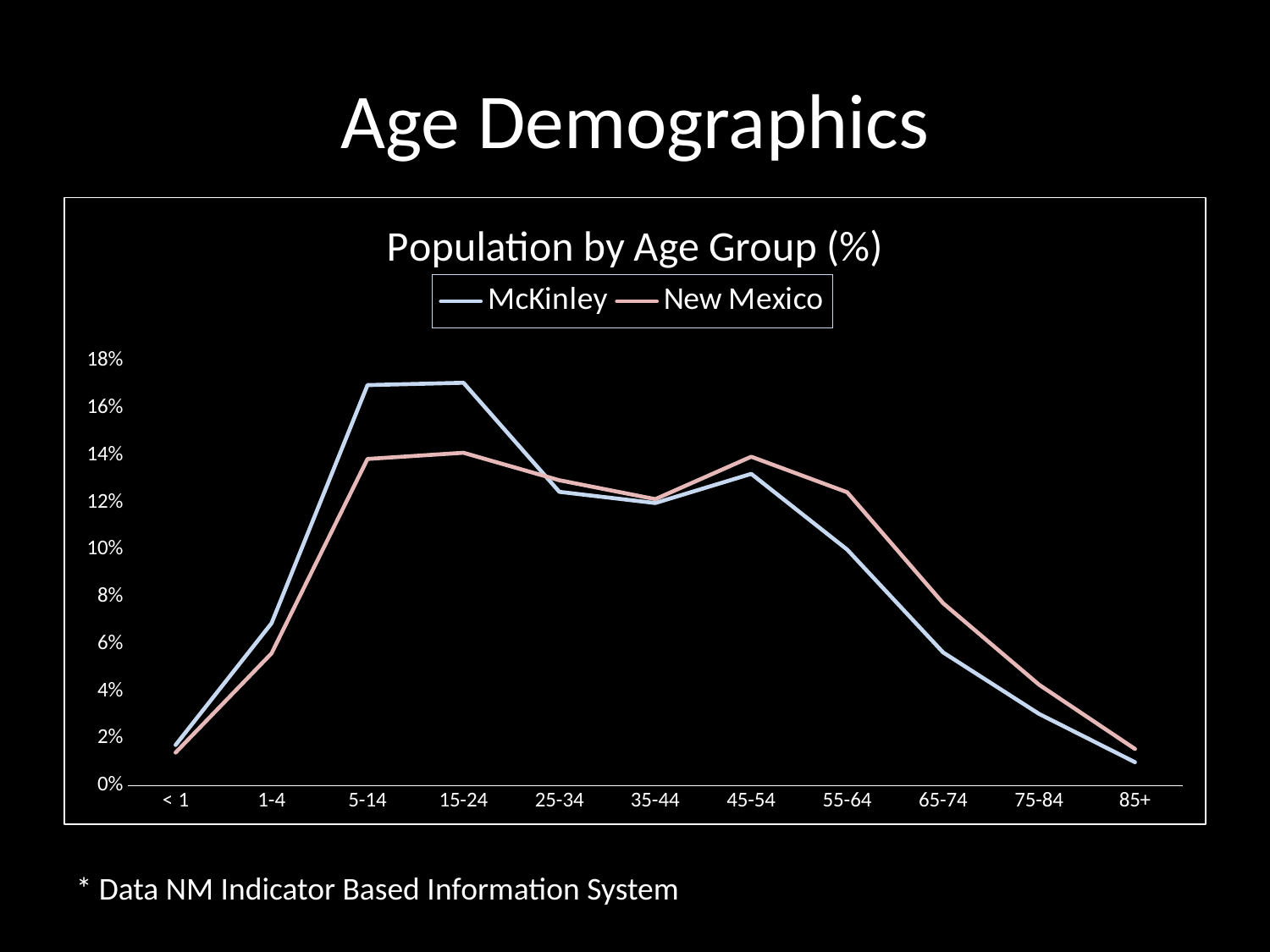
Is the McKinley value for the 65-74 age group greater or less than 8%? less How many series does the legend list? 2 Is the New Mexico value for the 55-64 age group greater or less than 10%? greater Do the McKinley values rise or fall from the 45-54 age group to the 85+ age group? fall What is the title of the chart? Population by Age Group (%) How many age groups are shown along the x axis? 11 What kind of chart is shown on the slide? Line chart For the 5-14 age group, which series has the higher value, McKinley or New Mexico? McKinley Which age group has the lowest value for the McKinley series? 85+ Is the McKinley value for the 5-14 age group greater or less than 16%? greater Which two series are listed in the legend? McKinley and New Mexico For the 55-64 age group, which series has the higher value, McKinley or New Mexico? New Mexico